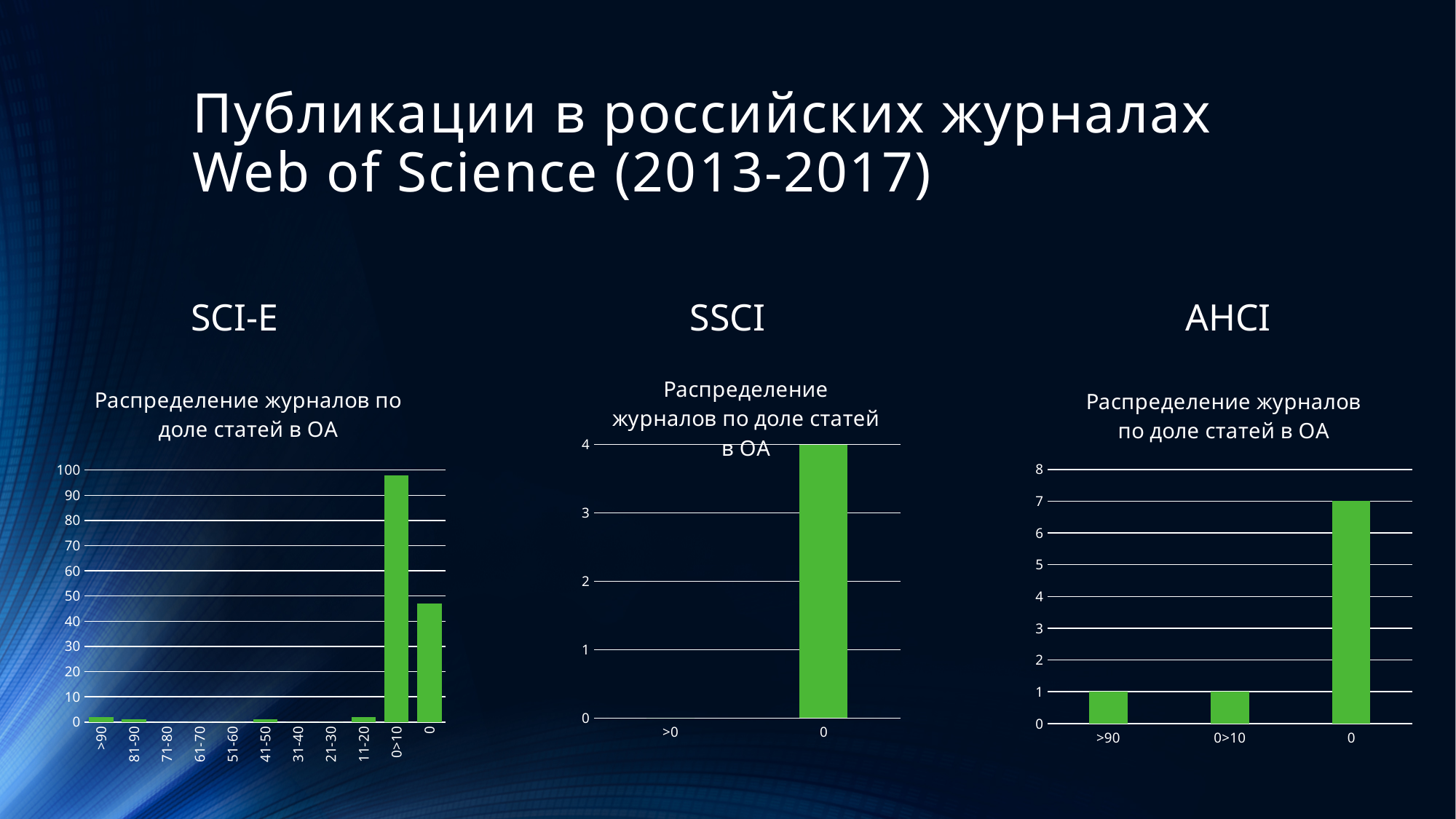
In the AHCI chart, what is the difference between the values for "0" and "0>10"? 6 In the AHCI chart, what is the value for the category ">90"? 1 In the SSCI chart, what is the value for the category ">0"? 0 In the AHCI chart, what is the value for the category "0"? 7 In the SCI-E chart, is the value for "0>10" greater or less than 90? greater In the SCI-E chart, is the value for "0" greater or less than 50? less How many categories are shown on the x axis of the SCI-E chart? 11 In the SSCI chart, what is the value for the category "0"? 4 In the SCI-E chart, which category has the highest value? 0>10 In the SCI-E chart, which is larger, the value for "0>10" or the value for "0"? 0>10 What type of chart is the AHCI chart? bar chart In the AHCI chart, which category has the highest value? 0